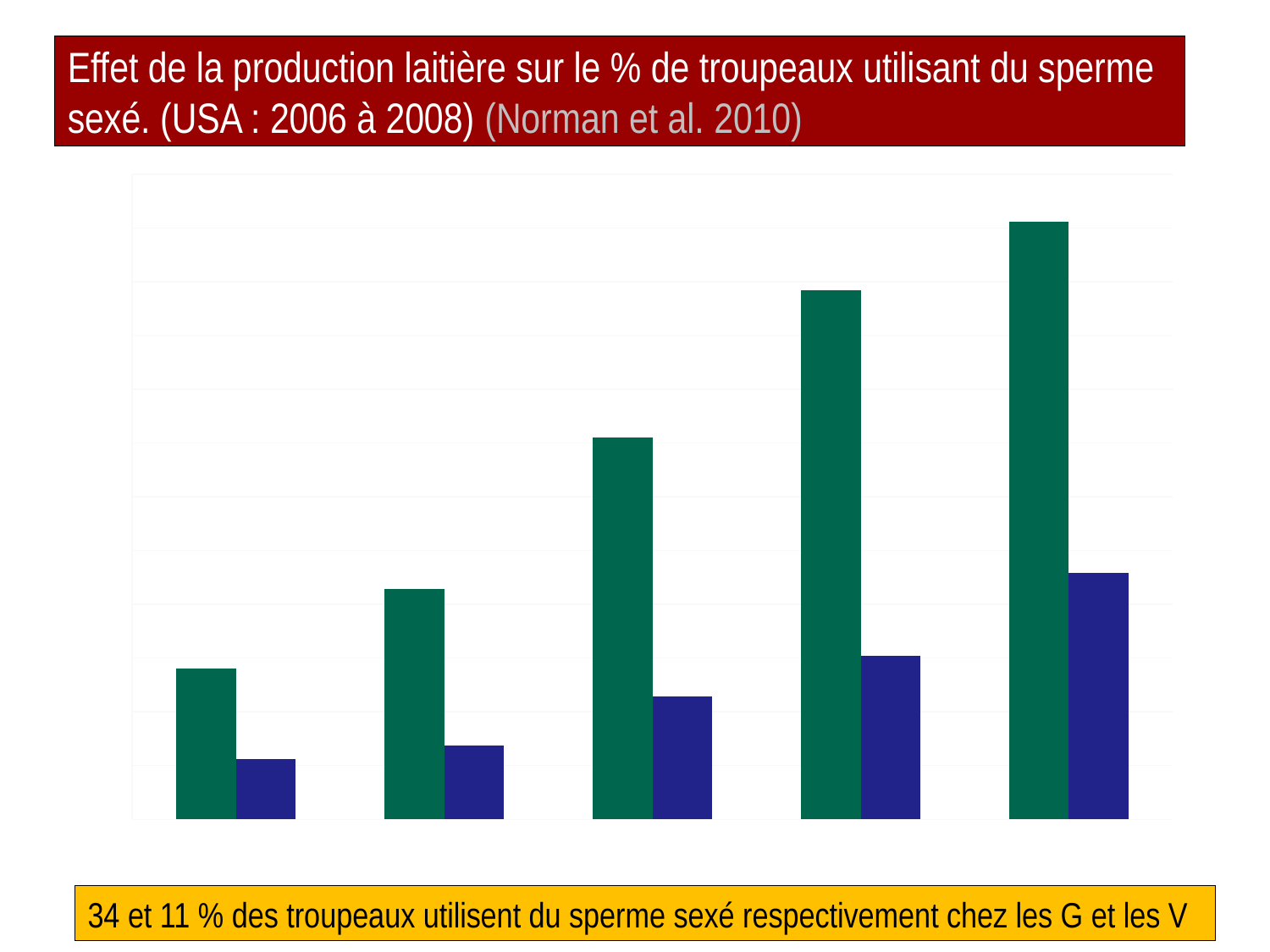
Which group of bars, counting from the left, has the shortest blue bar? the first (leftmost) group How many groups of bars (categories) are plotted on the chart? 5 Do the blue bars rise or fall from left to right across the chart? rise Do the green bars rise or fall from left to right across the chart? rise What kind of chart is shown on the slide? bar chart What is the title of the slide containing the chart? Effet de la production laitière sur le % de troupeaux utilisant du sperme sexé. (USA : 2006 à 2008) (Norman et al. 2010) Is the blue bar in the fifth group taller or shorter than the green bar in the second group? taller How many data series (bar colours) are plotted in each group on the chart? 2 Which group of bars, counting from the left, has the tallest green bar? the fifth (rightmost) group Is the green bar in the third group taller or shorter than the green bar in the fourth group? shorter In the rightmost group, which bar is taller, the green one or the blue one? the green one What two colours are used for the bars on the chart? green and blue